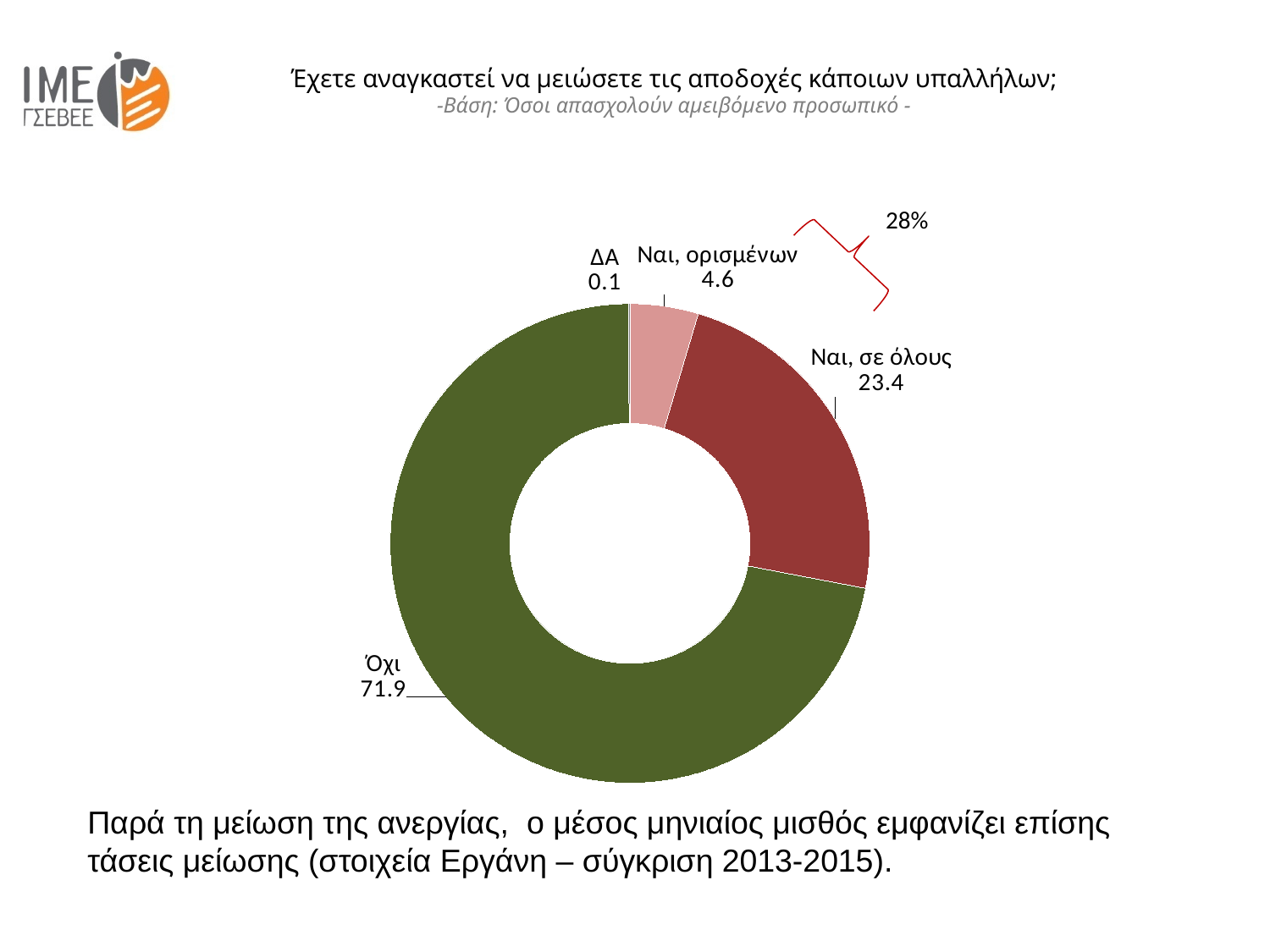
What is the title of the chart? Έχετε αναγκαστεί να μειώσετε τις αποδοχές κάποιων υπαλλήλων; Which is larger, the value for 'Ναι, σε όλους' or the value for 'Ναι, ορισμένων'? Ναι, σε όλους What value is shown for the 'Όχι' slice? 71.9 Which category has the largest slice? Όχι What is the difference between the values for 'Όχι' and 'Ναι, σε όλους'? 48.5 What kind of chart is shown on the slide? Doughnut (pie) chart How many categories are shown in the chart? 4 What value is shown for the 'Ναι, σε όλους' slice? 23.4 What value is shown for the 'Ναι, ορισμένων' slice? 4.6 What value is shown for the 'ΔΑ' slice? 0.1 What combined percentage is indicated by the bracket grouping the two 'Ναι' slices? 28% Which category has the smallest slice? ΔΑ